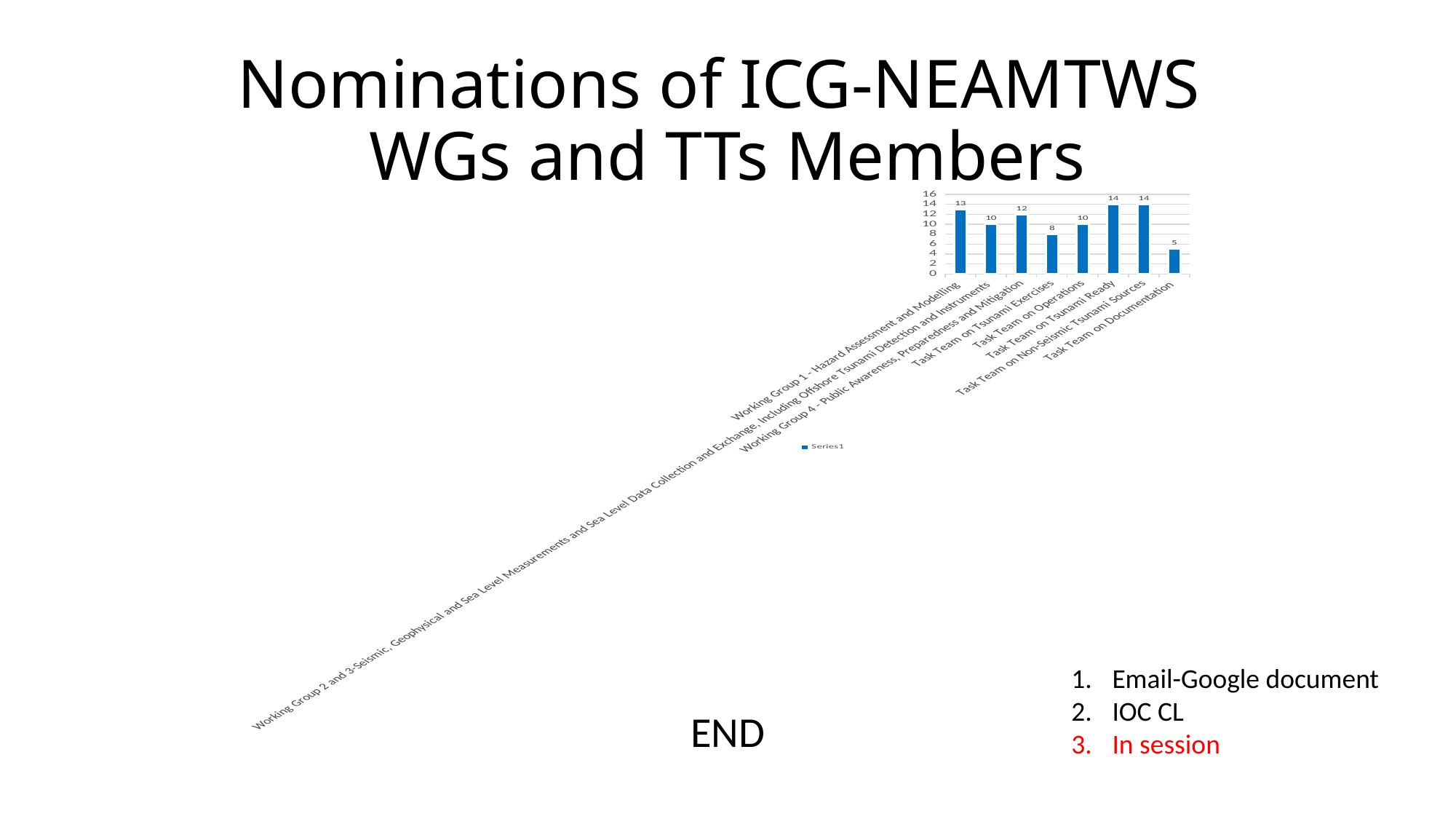
What is the value for Task Team on Tsunami Ready? 14 What is the value for Working Group 4 - Public Awareness, Preparedness and Mitigation? 12 What is the value for Task Team on Documentation? 5 What kind of chart is shown on the slide? bar chart How many categories are shown in the chart? 8 What is the difference between the values for Task Team on Non-Seismic Tsunami Sources and Task Team on Documentation? 9 Is the value for Task Team on Tsunami Exercises greater or less than 10? less What is the name of the series listed in the chart legend? Series1 Which is larger, the value for Working Group 1 - Hazard Assessment and Modelling or the value for Task Team on Operations? Working Group 1 - Hazard Assessment and Modelling Which category has the lowest value? Task Team on Documentation What is the value for Working Group 1 - Hazard Assessment and Modelling? 13 What is the value for Task Team on Tsunami Exercises? 8